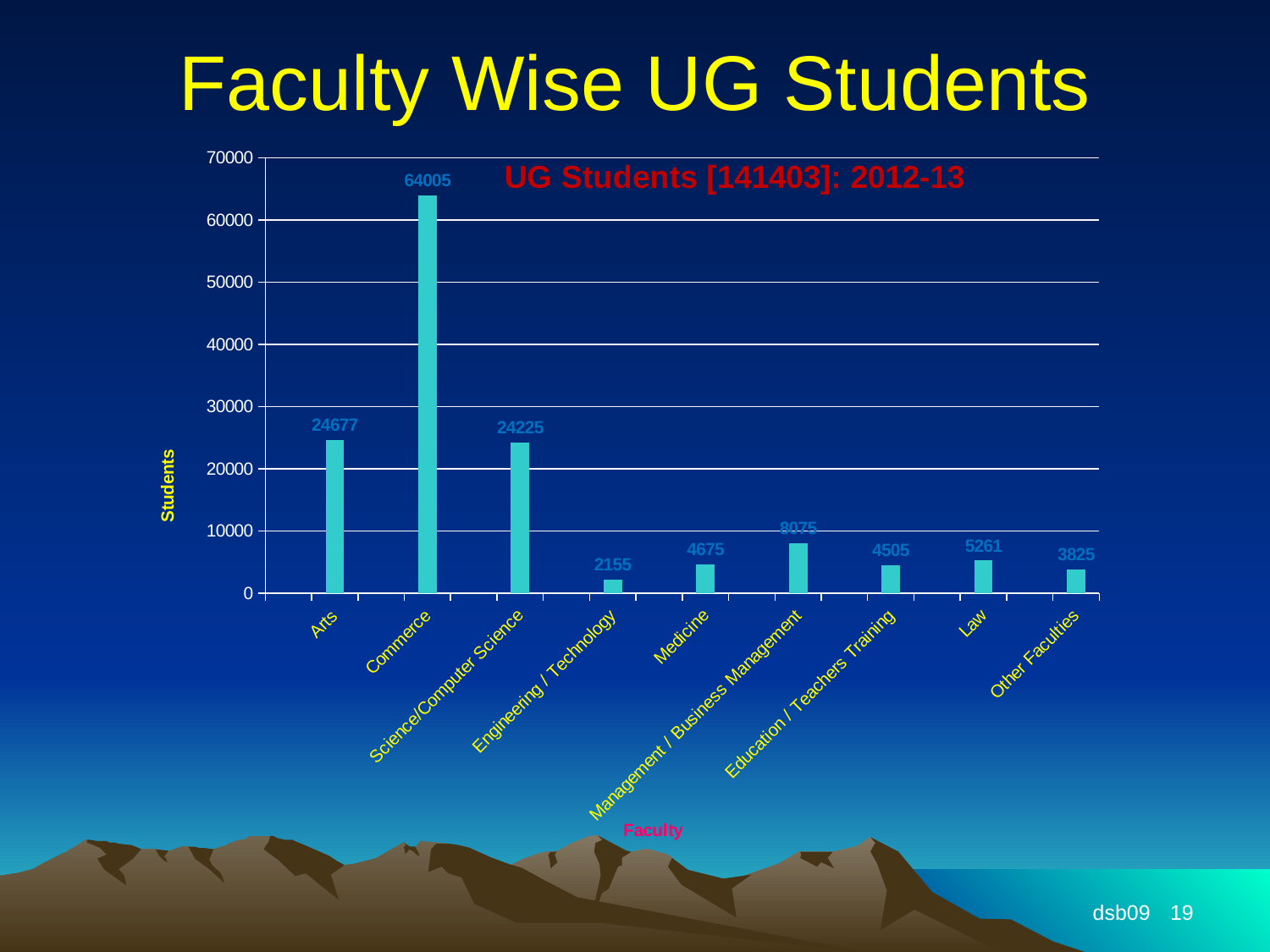
What is the difference between the Commerce and Arts values? 39328 How many UG students are in the Commerce faculty? 64005 What is the value for Law? 5261 What is the title printed inside the chart area? UG Students [141403]: 2012-13 Which faculty has the lowest number of UG students? Engineering / Technology How many faculty categories are shown on the x axis? 9 What is the value for Engineering / Technology? 2155 Is the value for Management / Business Management greater or less than 10000? less Which has more UG students, Arts or Science/Computer Science? Arts How many UG students are in the Arts faculty? 24677 Which faculty has the highest number of UG students? Commerce What kind of chart is shown on the slide? bar chart